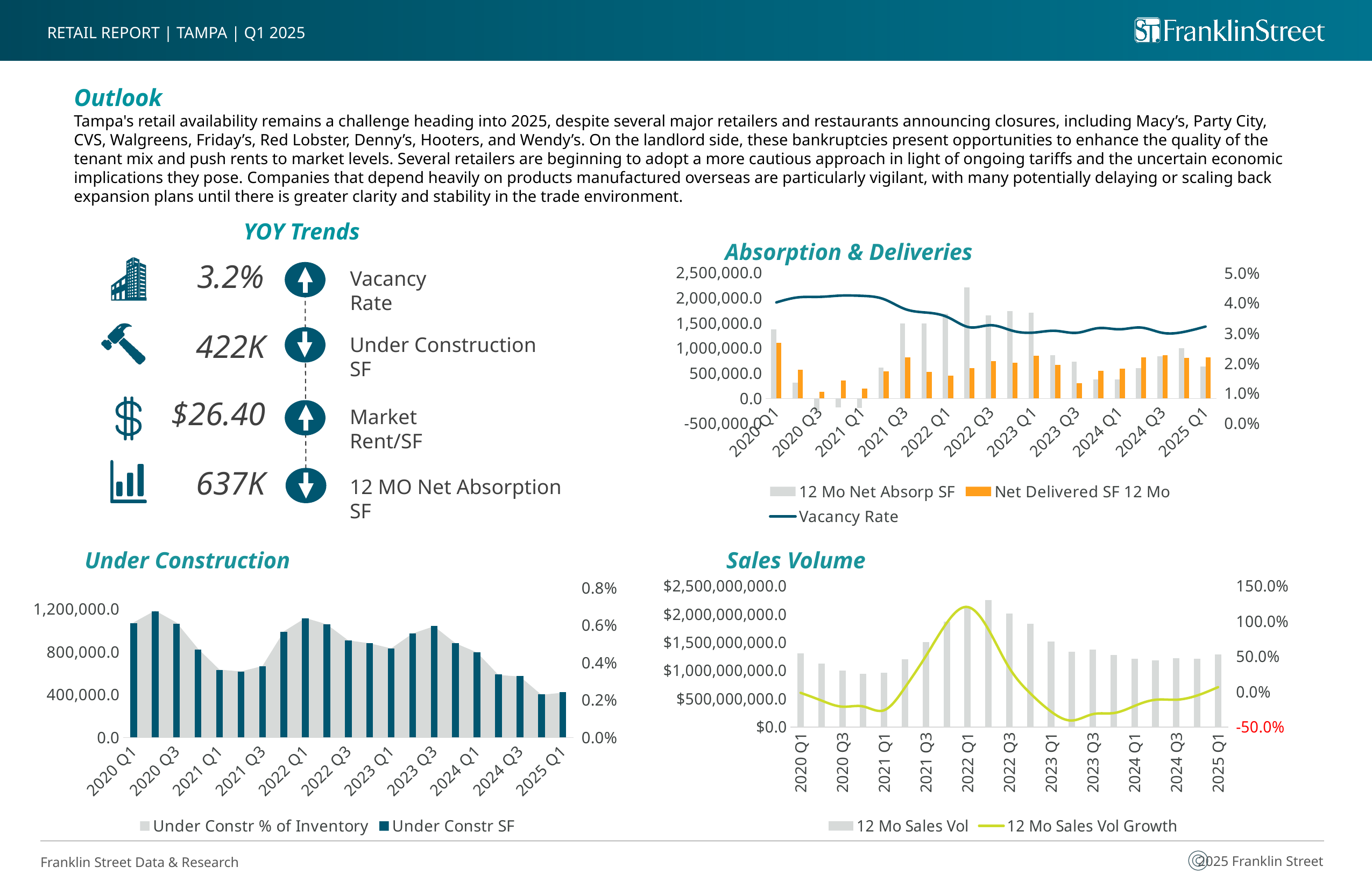
How many series does the legend of the Under Construction chart list? 2 In the Absorption & Deliveries chart, which series is drawn as a line rather than bars? Vacancy Rate How many series does the legend of the Absorption & Deliveries chart list? 3 In the Absorption & Deliveries chart, is the 12 Mo Net Absorp SF value for 2020 Q1 greater or less than 1,000,000.0? greater In the Under Construction chart, which is larger, the Under Constr SF value for 2020 Q1 or for 2025 Q1? 2020 Q1 In the Absorption & Deliveries chart, does the Vacancy Rate line overall rise or fall from 2020 Q1 to 2025 Q1? fall In the Under Construction chart, is the Under Constr SF value for 2024 Q3 greater or less than 800,000.0? less What kind of chart is the Sales Volume chart? Combined bar and line chart In the Sales Volume chart, is the 12 Mo Sales Vol Growth value for 2023 Q1 greater or less than 0.0%? less